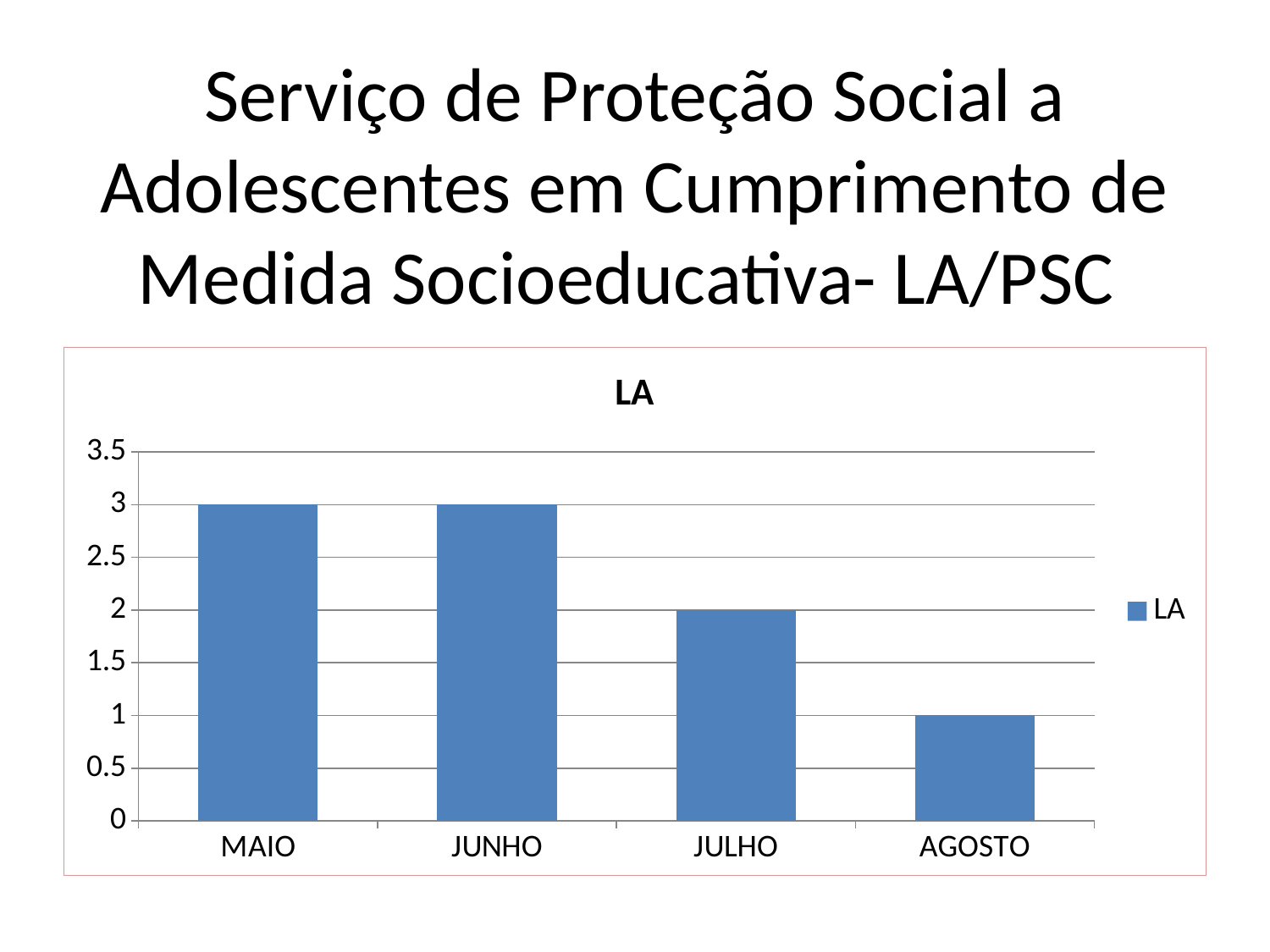
How many months are shown on the x axis of the LA chart? 4 What is the value for JULHO in the LA chart? 2 What kind of chart is shown on the slide? bar chart What is the value for JUNHO in the LA chart? 3 What is the difference between the values for JUNHO and JULHO in the LA chart? 1 How many series does the legend of the LA chart list? 1 What is the value for AGOSTO in the LA chart? 1 Which is larger in the LA chart, the value for JULHO or the value for AGOSTO? JULHO What is the value for MAIO in the LA chart? 3 What is the difference between the values for MAIO and AGOSTO in the LA chart? 2 Is the value for JULHO in the LA chart greater or less than 2.5? less Which month has the lowest value in the LA chart? AGOSTO